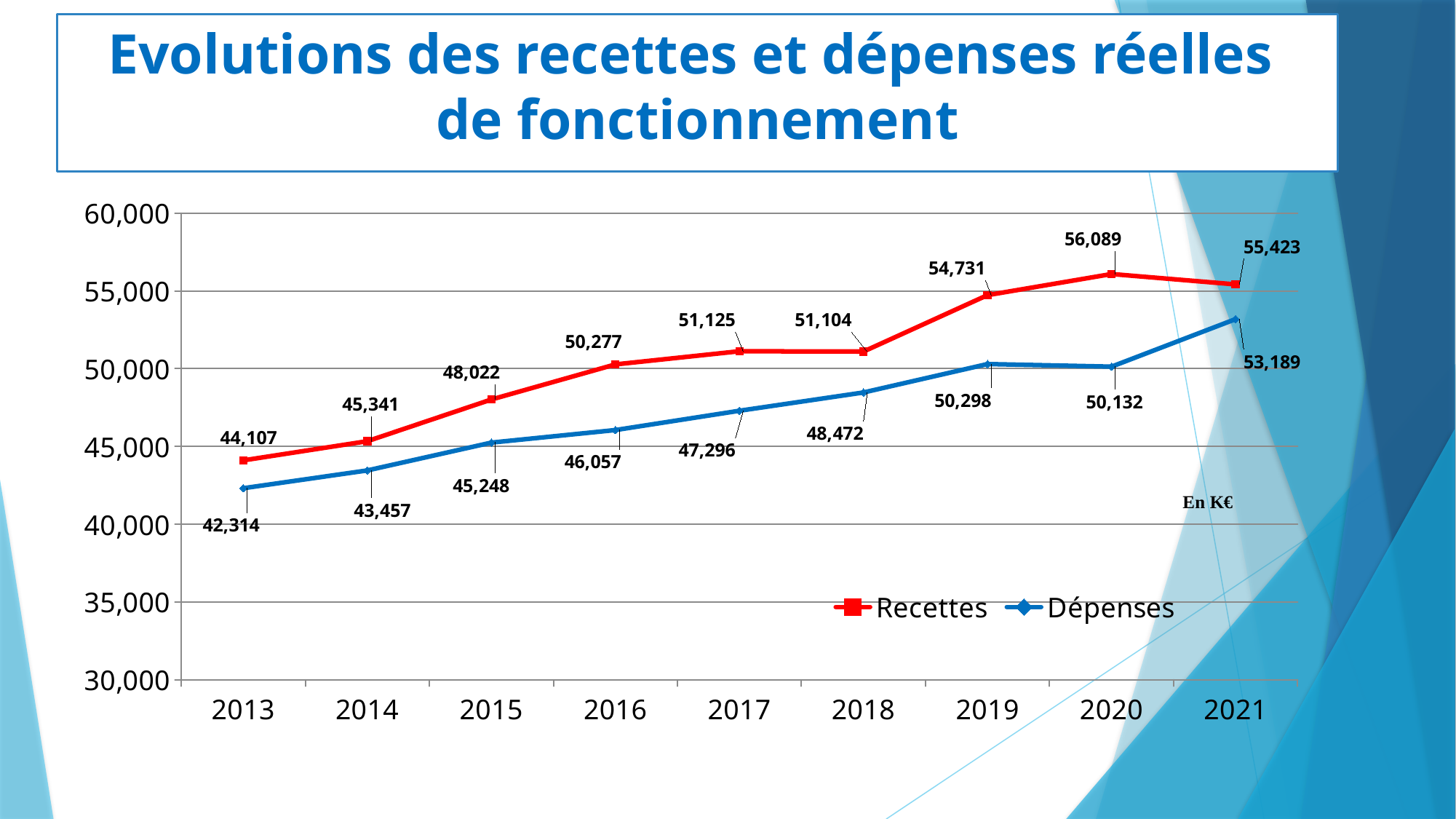
What unit is indicated on the chart? En K€ What is the difference between Recettes and Dépenses in 2021? 2,234 What is the value of Dépenses in 2019? 50,298 In which year is Recettes highest? 2020 What type of chart is shown on the slide? Line chart In which year is Dépenses lowest? 2013 Is the value of Dépenses in 2017 greater or less than 50,000? less Does Dépenses generally rise or fall from 2013 to 2021? Rise How many series does the legend list? 2 What is the value of Recettes in 2016? 50,277 Which is larger in 2018, Recettes or Dépenses? Recettes How many years are plotted on the x axis? 9